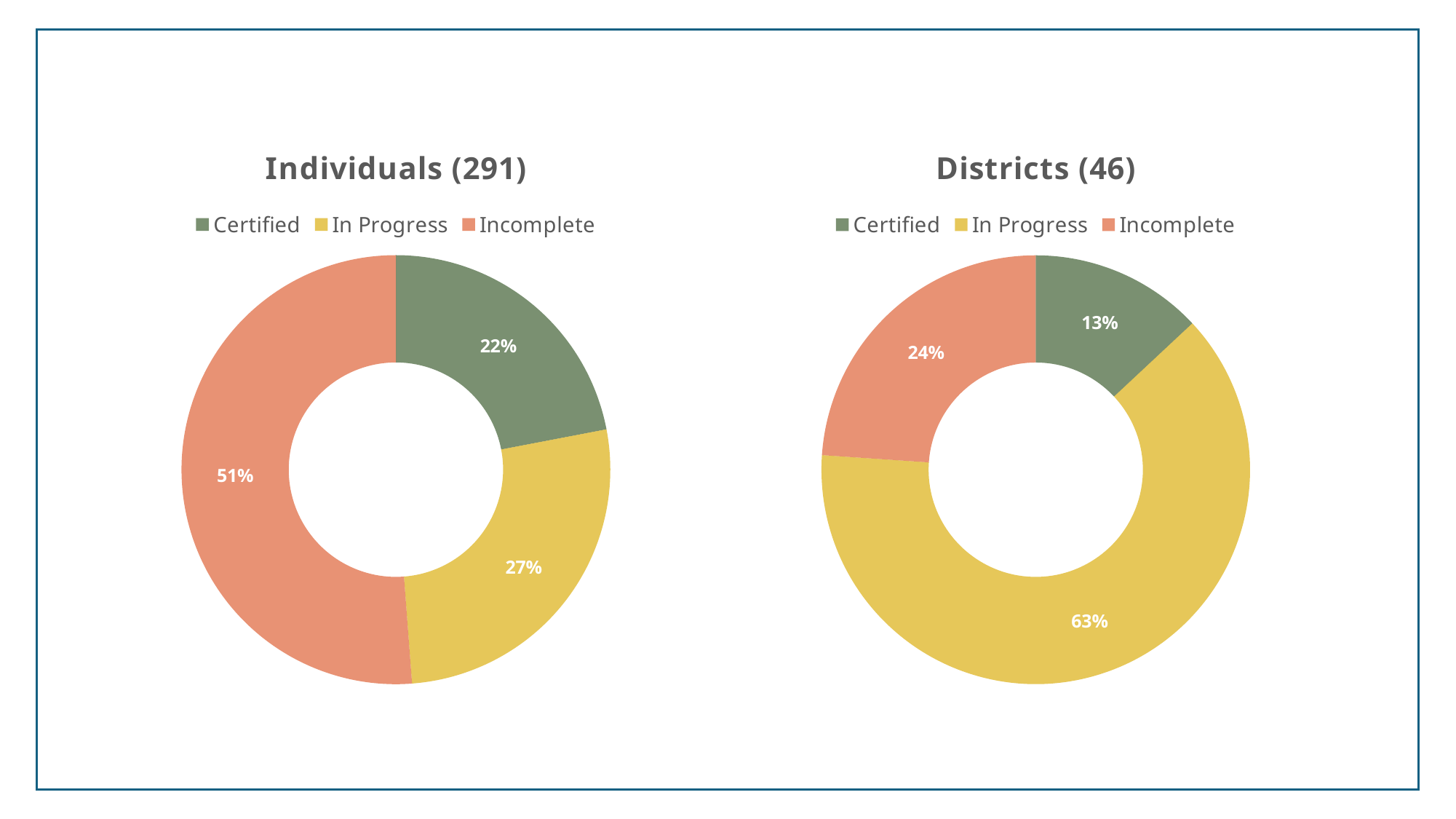
What kind of chart is the 'Individuals (291)' chart? Doughnut chart In the 'Districts (46)' chart, which is larger: In Progress or Incomplete? In Progress In the 'Individuals (291)' chart, what is the difference in percentage points between Incomplete and In Progress? 24 What colour represents In Progress in the 'Districts (46)' chart? Yellow In the 'Districts (46)' chart, what percentage is In Progress? 63% How many categories does the 'Districts (46)' chart show? 3 In the 'Individuals (291)' chart, what percentage is Certified? 22% How many entries does the legend of the 'Individuals (291)' chart list? 3 In the 'Individuals (291)' chart, which category has the largest share? Incomplete In the 'Districts (46)' chart, what percentage is Certified? 13% In the 'Individuals (291)' chart, what percentage is Incomplete? 51% In the 'Districts (46)' chart, which category has the smallest share? Certified